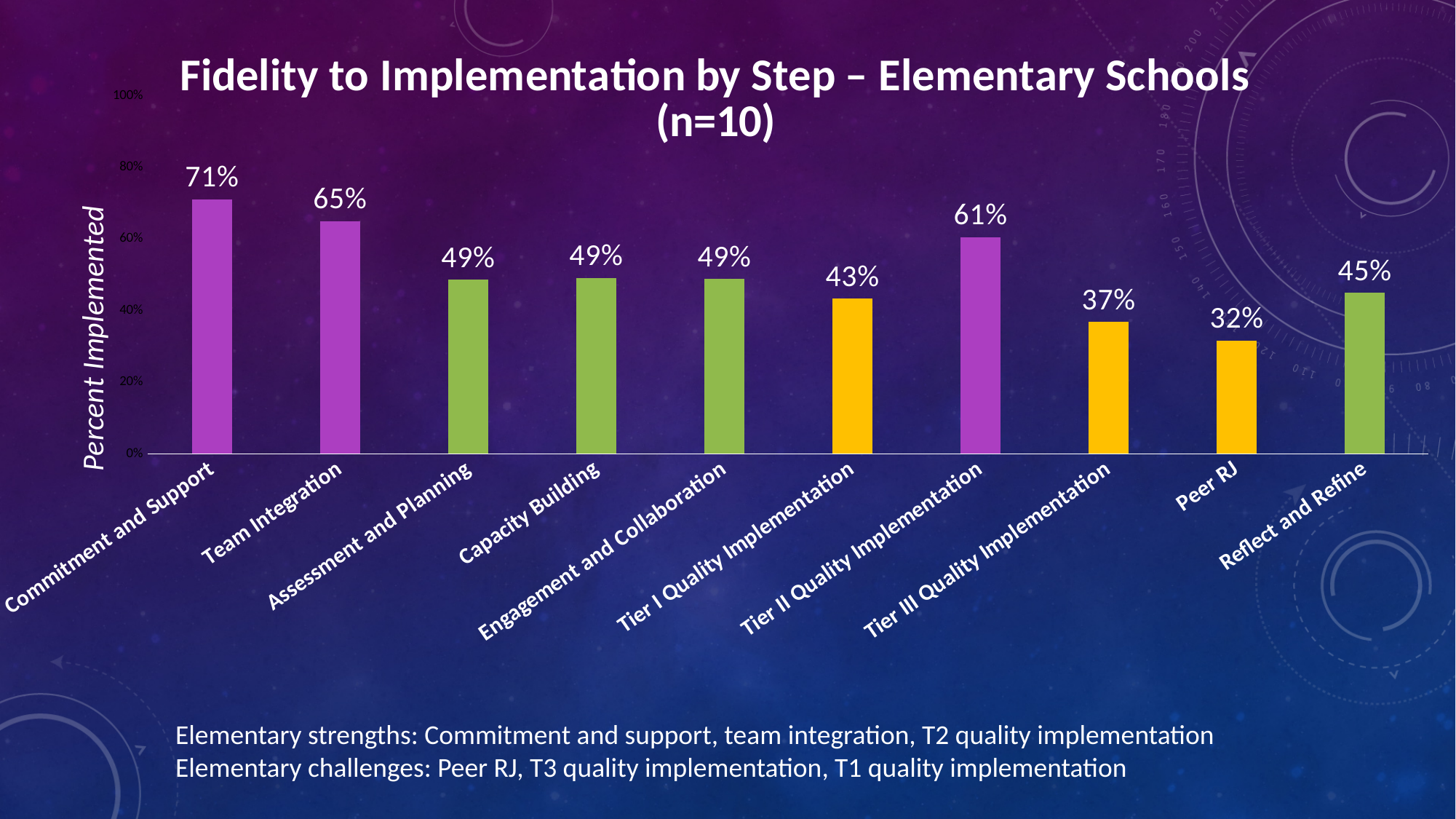
Which step has the highest percent implemented? Commitment and Support Which step has the lowest percent implemented? Peer RJ What is the difference between Team Integration and Tier III Quality Implementation? 28% How many steps are shown on the x axis? 10 Which is larger, Tier I Quality Implementation or Reflect and Refine? Reflect and Refine What is the value for Commitment and Support? 71% What is the value for Tier II Quality Implementation? 61% Is the value for Tier II Quality Implementation greater or less than 60%? greater What is the label of the vertical axis? Percent Implemented What is the value for Peer RJ? 32% What kind of chart is this? bar chart What is the value for Reflect and Refine? 45%